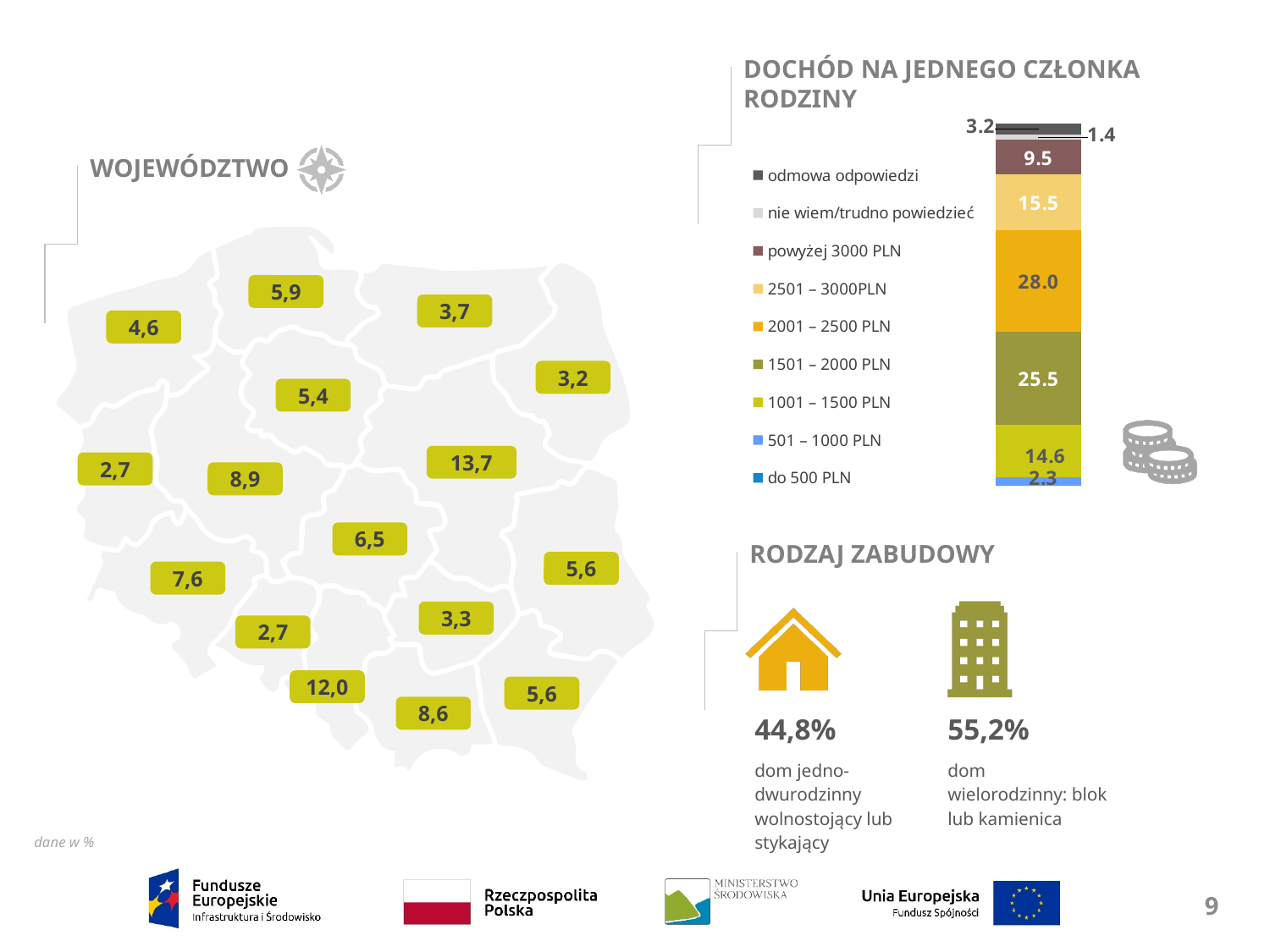
In the DOCHÓD NA JEDNEGO CZŁONKA RODZINY chart, what is the difference between the powyżej 3000 PLN segment and the odmowa odpowiedzi segment? 6.3 In the DOCHÓD NA JEDNEGO CZŁONKA RODZINY chart, what is the difference between the 2001 – 2500 PLN segment and the 1501 – 2000 PLN segment? 2.5 How many entries does the legend of the DOCHÓD NA JEDNEGO CZŁONKA RODZINY chart list? 9 In the DOCHÓD NA JEDNEGO CZŁONKA RODZINY chart, what is the value for the 1001 – 1500 PLN segment? 14.6 In the DOCHÓD NA JEDNEGO CZŁONKA RODZINY chart, what is the total of all labelled segments in the stacked bar? 100.0 In the DOCHÓD NA JEDNEGO CZŁONKA RODZINY chart, which income category has the largest segment? 2001 – 2500 PLN In the DOCHÓD NA JEDNEGO CZŁONKA RODZINY chart, what is the value for the 501 – 1000 PLN segment? 2.3 What kind of chart is the DOCHÓD NA JEDNEGO CZŁONKA RODZINY chart? Stacked bar chart In the DOCHÓD NA JEDNEGO CZŁONKA RODZINY chart, what is the value for the 2001 – 2500 PLN segment? 28.0 In the DOCHÓD NA JEDNEGO CZŁONKA RODZINY chart, which is larger: the 2501 – 3000PLN segment or the 1001 – 1500 PLN segment? 2501 – 3000PLN In the DOCHÓD NA JEDNEGO CZŁONKA RODZINY chart, what is the value for the powyżej 3000 PLN segment? 9.5 In the DOCHÓD NA JEDNEGO CZŁONKA RODZINY chart, what is the value for the 1501 – 2000 PLN segment? 25.5